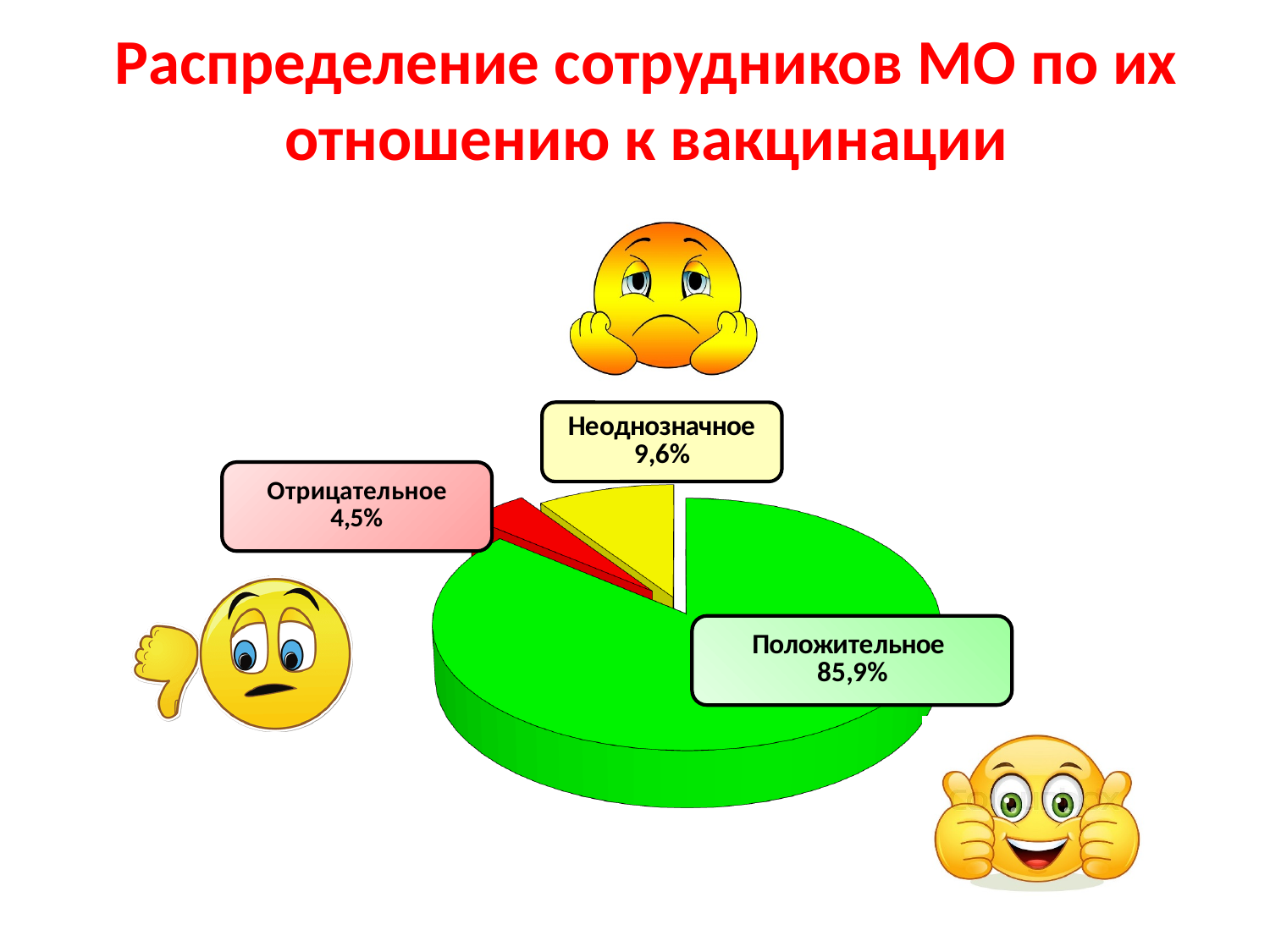
Which category has the largest share of the pie? Положительное What is the difference in percentage points between the Положительное and Неоднозначное shares? 76,3 What is the difference in percentage points between the Неоднозначное and Отрицательное shares? 5,1 What colour is the slice for Положительное? green What is the title of the chart on the slide? Распределение сотрудников МО по их отношению к вакцинации What share of employees have a negative (Отрицательное) attitude to vaccination? 4,5% What share of employees have an ambiguous (Неоднозначное) attitude to vaccination? 9,6% What kind of chart is shown on the slide? pie chart How many categories are shown in the pie chart? 3 Which category has the smallest share of the pie? Отрицательное Which is larger, the share for Неоднозначное or the share for Отрицательное? Неоднозначное What share of employees have a positive (Положительное) attitude to vaccination? 85,9%